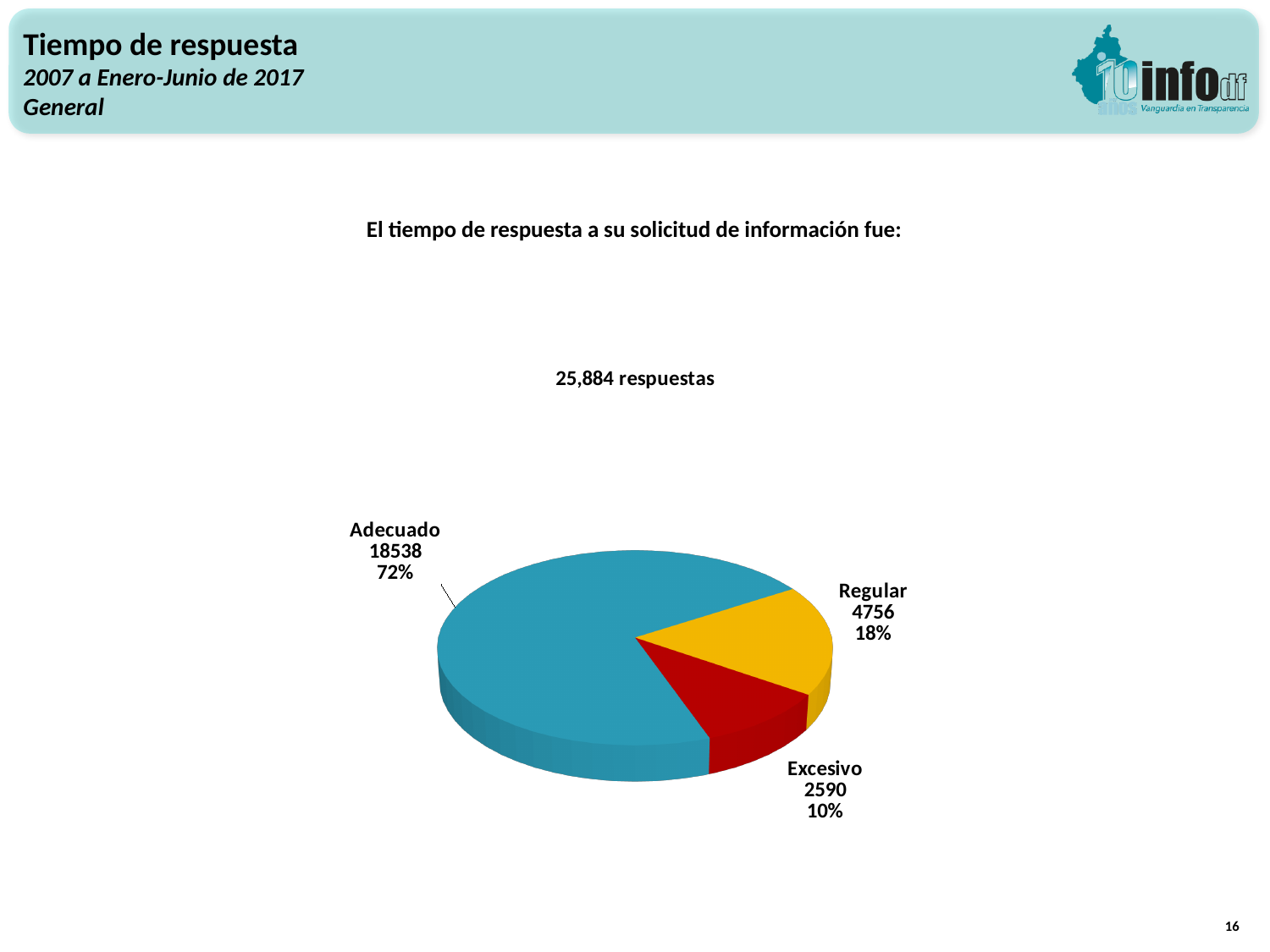
What is the value for Adecuado? 18538 What is the value for Excesivo? 2590 What kind of chart is shown on the slide? pie chart What is the difference between the values for Regular and Excesivo? 2166 What share of the pie does Excesivo represent? 10% What share of the pie does Adecuado represent? 72% Which category has the smallest slice? Excesivo What is the value for Regular? 4756 How many slices does the pie chart have? 3 Which is larger, the value for Regular or the value for Excesivo? Regular How many total responses does the chart report? 25,884 respuestas Which category has the largest slice? Adecuado